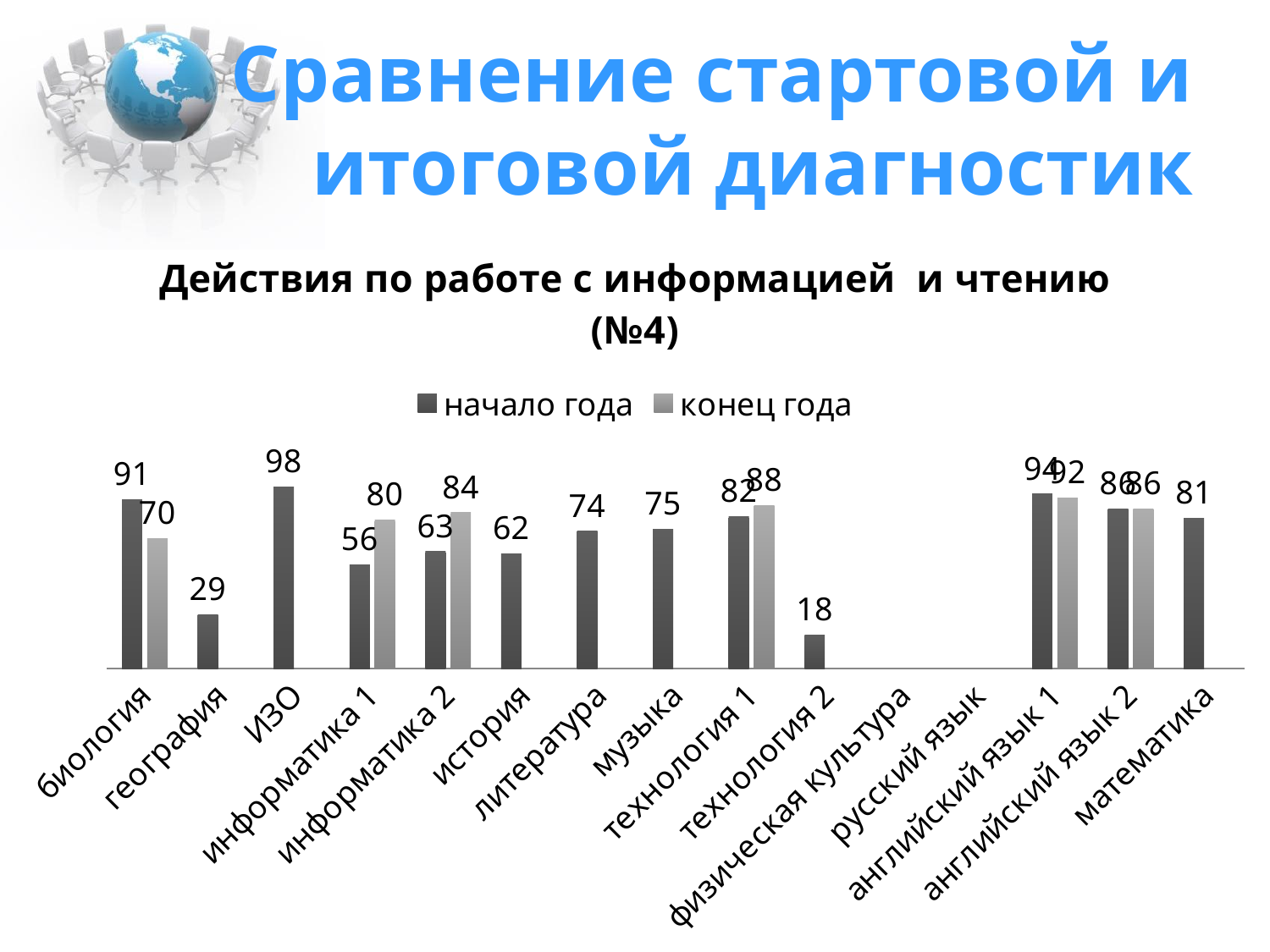
What is the title of the chart? Действия по работе с информацией и чтению (№4) How many categories are shown on the x axis? 15 What is the конец года value for информатика 1? 80 Which category has the highest начало года value? ИЗО What type of chart is shown on the slide? bar chart For информатика 2, which is larger: the начало года value or the конец года value? конец года What is the начало года value for технология 2? 18 What is the difference between the начало года and конец года values for биология? 21 What is the value for ИЗО in the начало года series? 98 How many series does the legend list? 2 Which category has the lowest начало года value? технология 2 What is the difference between the конец года and начало года values for технология 1? 6